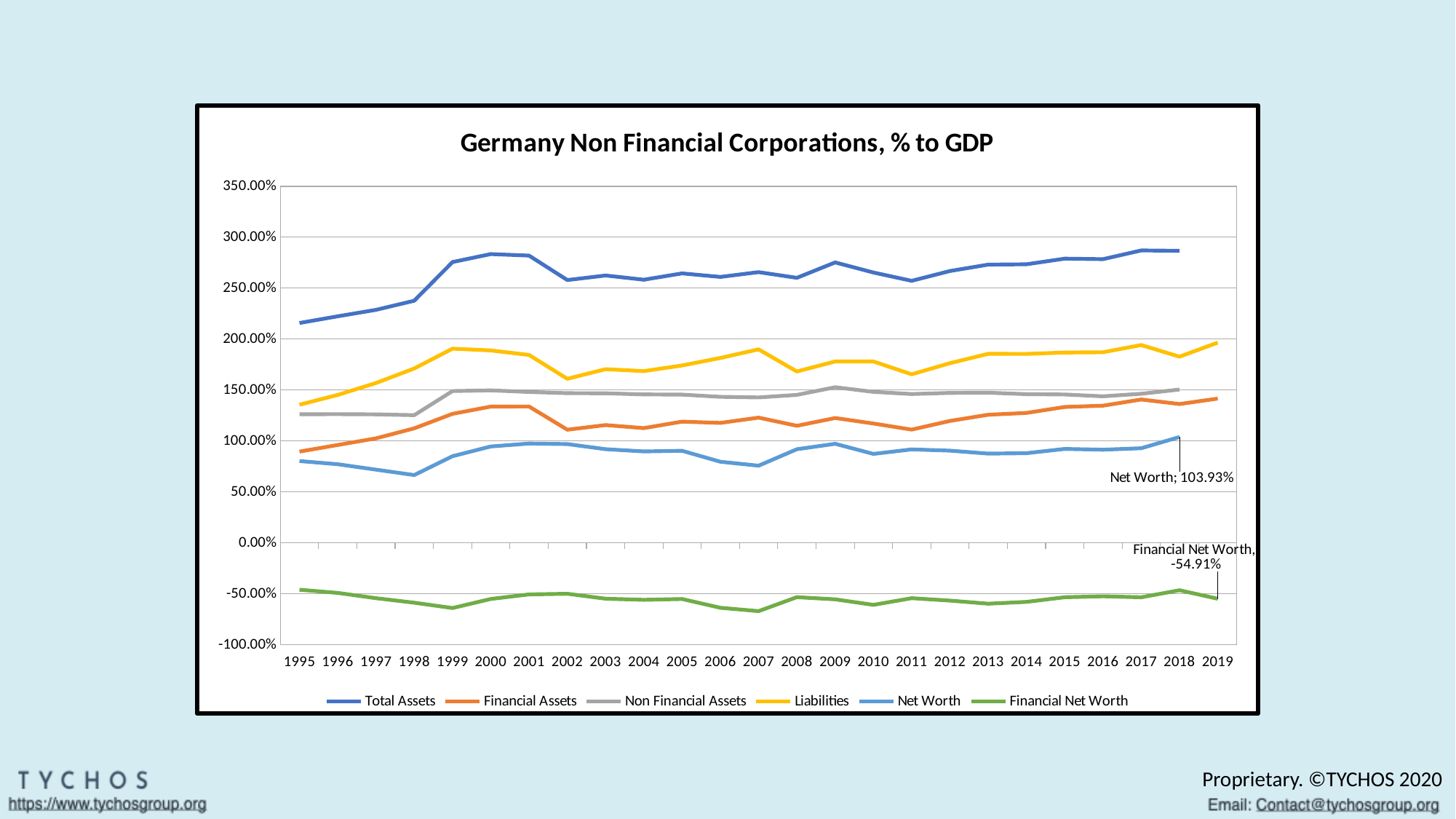
What kind of chart is shown on the slide? Line chart Is the value for Total Assets in 1995 greater or less than 200%? greater In 2010, which is larger: Total Assets or Liabilities? Total Assets How many years are shown on the x axis? 25 What is the labelled value for Financial Net Worth in 2019? -54.91% How many series does the legend list? 6 What is the labelled value for Net Worth at the end of its line? 103.93% Is the value for Liabilities in 2019 greater or less than 150%? greater Does the Total Assets line rise or fall from 1995 to 1999? Rise Which series has the lowest values throughout the chart? Financial Net Worth Which series has the highest values throughout the chart? Total Assets Is the value for Financial Net Worth in 2007 greater or less than -50%? less